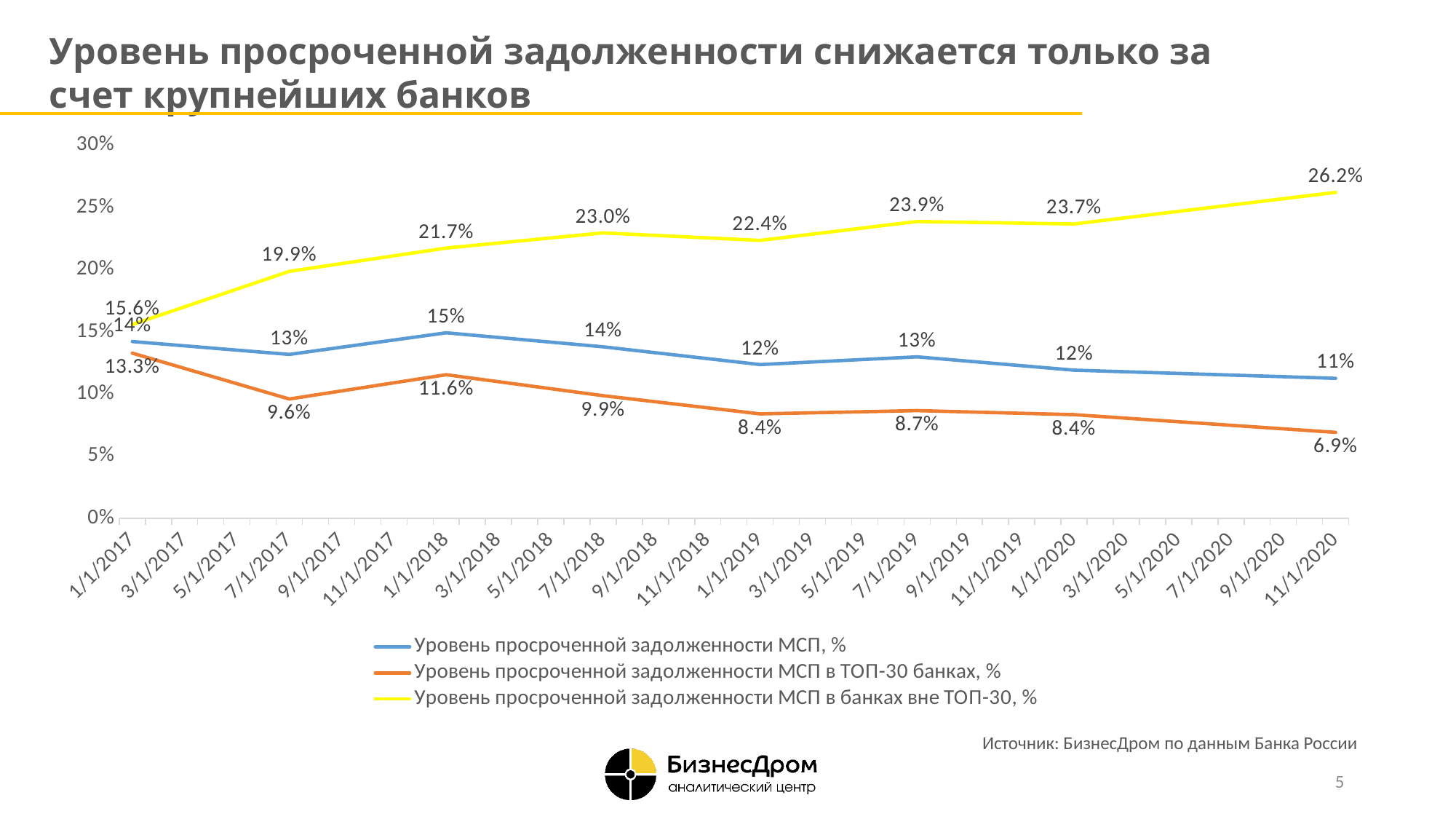
How many series does the legend list? 3 What is the value of the yellow series (Уровень просроченной задолженности МСП в банках вне ТОП-30, %) at 11/1/2020? 26.2% What is the value of the orange series (Уровень просроченной задолженности МСП в ТОП-30 банках, %) at 7/1/2017? 9.6% Which series has the higher value at 1/1/2019: the yellow series (вне ТОП-30) or the orange series (ТОП-30 банках)? Yellow series (вне ТОП-30) What is the difference between the yellow series value at 11/1/2020 (26.2%) and at 1/1/2017 (15.6%)? 10.6% What is the value of the orange series (ТОП-30 банках) at 11/1/2020? 6.9% At which labelled date does the orange series (ТОП-30 банках) reach its lowest value? 11/1/2020 Does the yellow series (вне ТОП-30) generally rise or fall from 1/1/2017 to 11/1/2020? Rise What is the value of the blue series (Уровень просроченной задолженности МСП, %) at 1/1/2018? 15% Is the value of the orange series (ТОП-30 банках) at 11/1/2020 greater or less than 10%? less What kind of chart is shown on the slide? Line chart At which labelled date does the yellow series (вне ТОП-30) reach its highest value? 11/1/2020